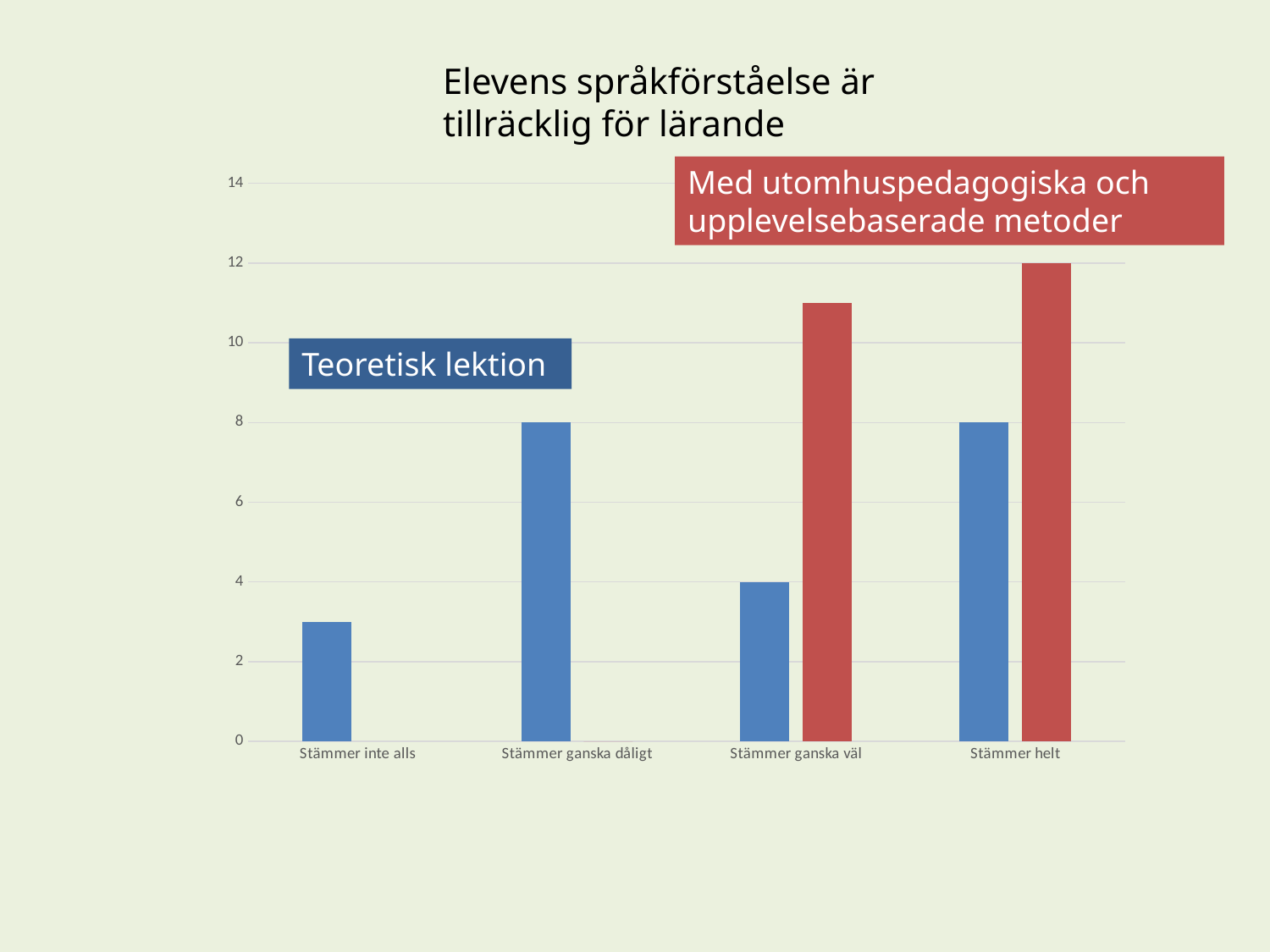
How many categories are shown on the x axis? 4 Is the value for 'Teoretisk lektion' in 'Stämmer inte alls' greater or less than 4? less In the category 'Stämmer helt', which series has the larger value? Med utomhuspedagogiska och upplevelsebaserade metoder What is the value for 'Teoretisk lektion' in the category 'Stämmer ganska dåligt'? 8 What kind of chart is shown on the slide? bar chart Which category has the lowest value for 'Teoretisk lektion'? Stämmer inte alls In the category 'Stämmer helt', what is the difference between the value for 'Med utomhuspedagogiska och upplevelsebaserade metoder' and the value for 'Teoretisk lektion'? 4 What is the title of the chart? Elevens språkförståelse är tillräcklig för lärande What is the value for 'Teoretisk lektion' in the category 'Stämmer ganska väl'? 4 What is the value for 'Med utomhuspedagogiska och upplevelsebaserade metoder' in the category 'Stämmer helt'? 12 How many data series does the chart show? 2 Is the value for 'Med utomhuspedagogiska och upplevelsebaserade metoder' in 'Stämmer ganska väl' greater or less than 10? greater